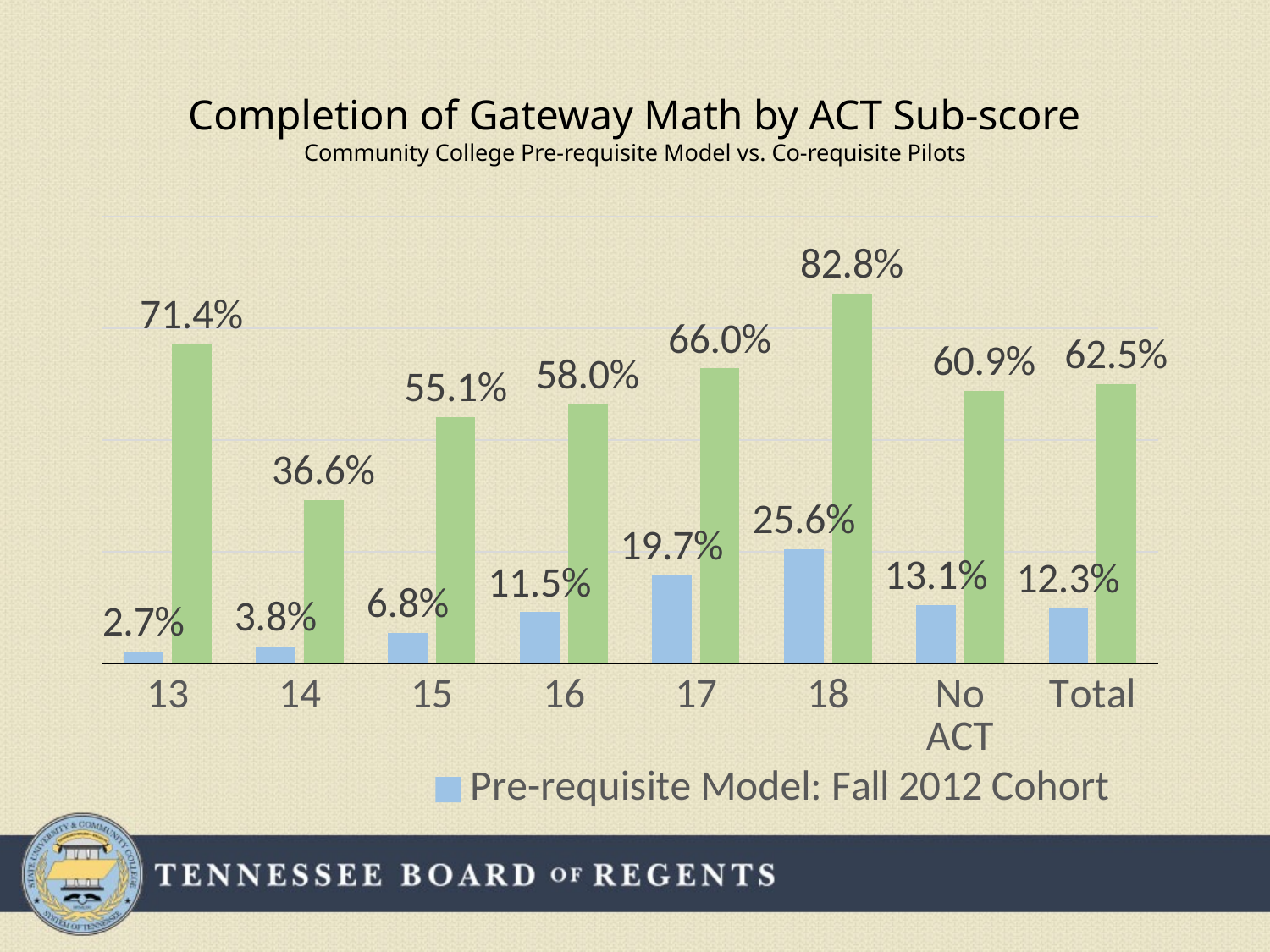
Do the Pre-requisite Model: Fall 2012 Cohort values rise or fall from ACT sub-score 13 to 18? Rise Which category has the lowest Pre-requisite Model: Fall 2012 Cohort value? 13 What is the Pre-requisite Model: Fall 2012 Cohort value for the Total category? 12.3% What is the value of the green bar for ACT sub-score 13? 71.4% For ACT sub-score 18, what is the difference between the green bar value and the Pre-requisite Model: Fall 2012 Cohort value? 57.2 percentage points What kind of chart is shown on the slide? Bar chart Which category has the highest value among the green bars? 18 For the Total category, what is the difference between the green bar value and the Pre-requisite Model: Fall 2012 Cohort value? 50.2 percentage points How many categories are shown on the x axis? 8 What is the Pre-requisite Model: Fall 2012 Cohort value for ACT sub-score 18? 25.6% Which has the larger green bar value, ACT sub-score 15 or 16? 16 Which category has the lowest value among the green bars? 14